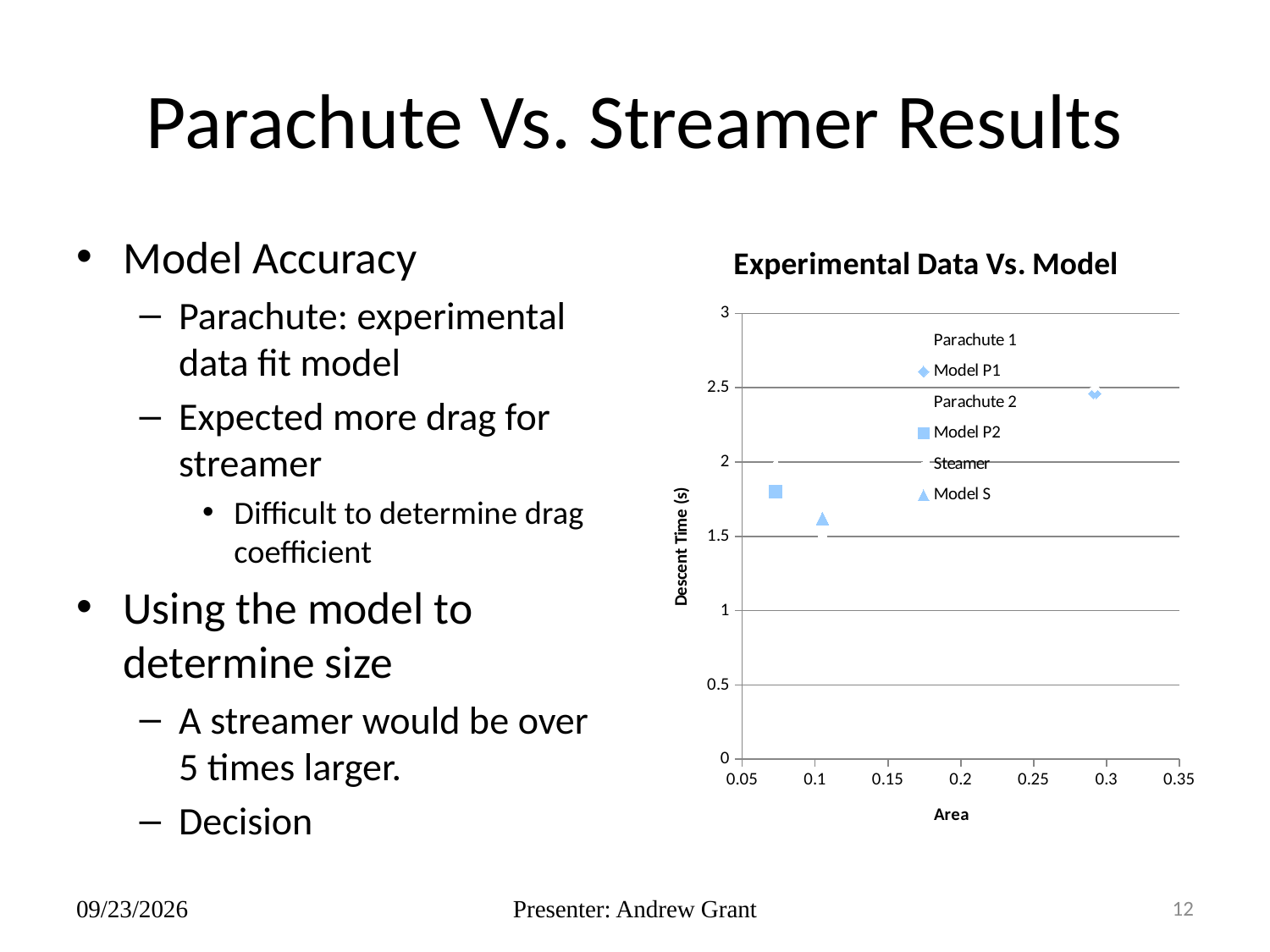
Is the area for the Model P2 point greater or less than 0.1? less Is the area for the Model P1 point greater or less than 0.25? greater What is the title of the chart? Experimental Data Vs. Model Is the descent time for the Model P1 point greater or less than 2? greater Which plotted point has the lowest descent time? Model S How many series does the chart legend list? 6 What is the label of the vertical axis of the chart? Descent Time (s) Which plotted point has the highest descent time? Model P1 Which plotted point has the highest descent time, Model P1 or Model S? Model P1 What kind of chart is shown on the slide? scatter chart